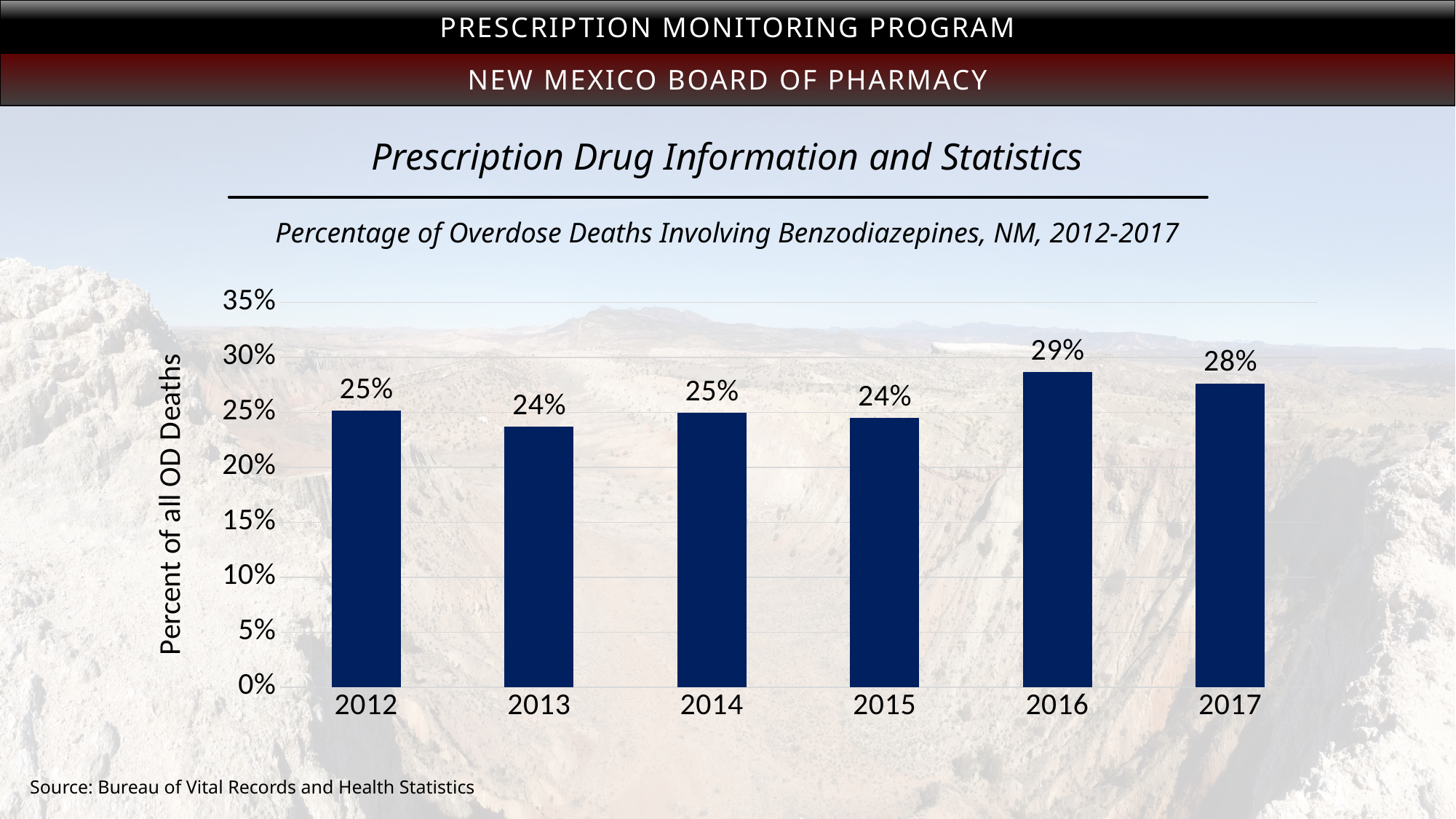
How many years are shown on the x axis of the chart? 6 Which year has the highest percentage of overdose deaths involving benzodiazepines? 2016 Is the value for 2016 greater or less than 25%? greater What is the value shown for 2013? 24% What is the difference between the values for 2016 and 2015? 5% What percentage of overdose deaths involved benzodiazepines in 2016? 29% What is the label on the vertical axis of the chart? Percent of all OD Deaths What is the value shown for 2017? 28% What is the difference between the values for 2017 and 2012? 3% What kind of chart is shown on the slide? Bar chart Which is larger, the value for 2016 or the value for 2017? 2016 Is the value for 2013 greater or less than 30%? less